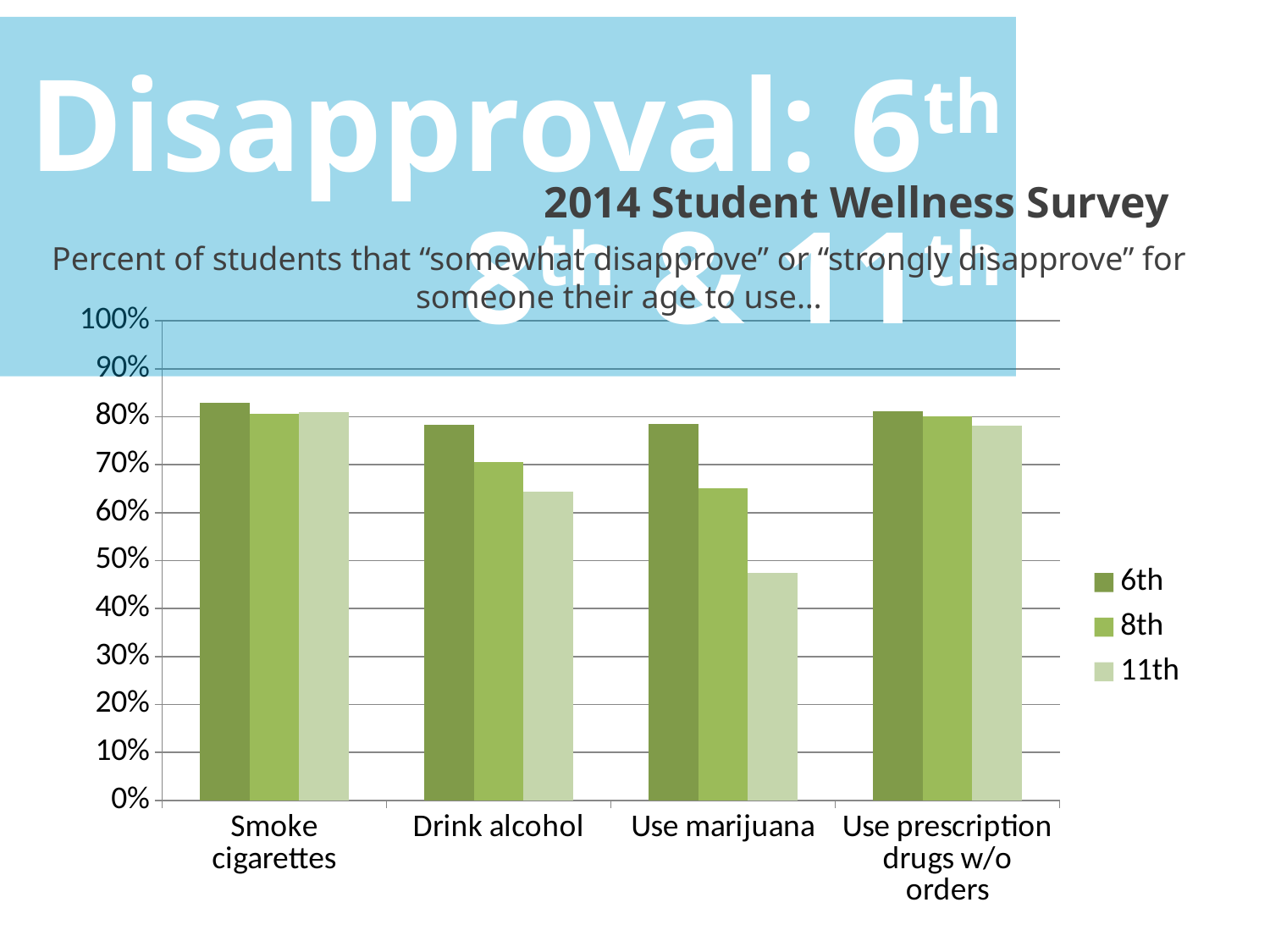
Is the value for 11th graders for Drink alcohol greater or less than 70%? less How many categories are shown on the x axis? 4 For Use marijuana, which is larger: the 6th grade value or the 11th grade value? 6th Is the value for 6th graders for Smoke cigarettes greater or less than 80%? greater How many series does the legend list? 3 What kind of chart is shown on the slide? bar chart Which category has the lowest value for 8th graders? Use marijuana Is the value for 8th graders for Use marijuana greater or less than 60%? greater For Drink alcohol, which is larger: the 8th grade value or the 11th grade value? 8th Which category has the lowest value for 11th graders? Use marijuana What are the three entries in the chart's legend? 6th, 8th, 11th